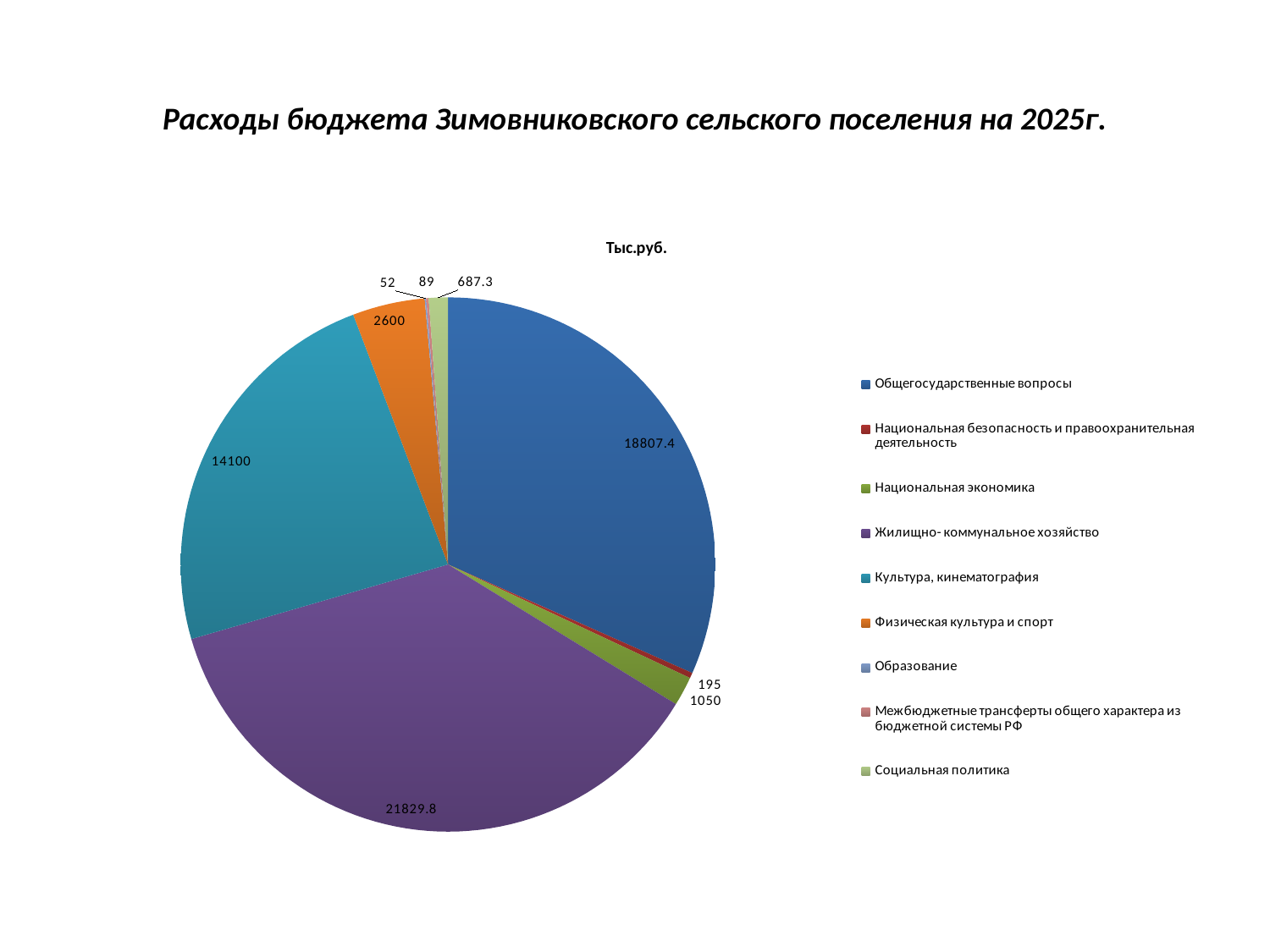
How many categories does the pie chart have? 9 What is the value for Общегосударственные вопросы? 18807.4 What is the value for Физическая культура и спорт? 2600 What is the difference between the values for Жилищно-коммунальное хозяйство and Общегосударственные вопросы? 3022.4 What is the value for Культура, кинематография? 14100 What is the difference between the values for Физическая культура и спорт and Национальная экономика? 1550 What is the value for Образование? 52 Which is larger, the value for Национальная экономика or the value for Социальная политика? Национальная экономика Which category has the smallest slice of the pie? Образование Which category has the largest slice of the pie? Жилищно-коммунальное хозяйство What kind of chart is shown on the slide? pie chart What is the value for Межбюджетные трансферты общего характера из бюджетной системы РФ? 89